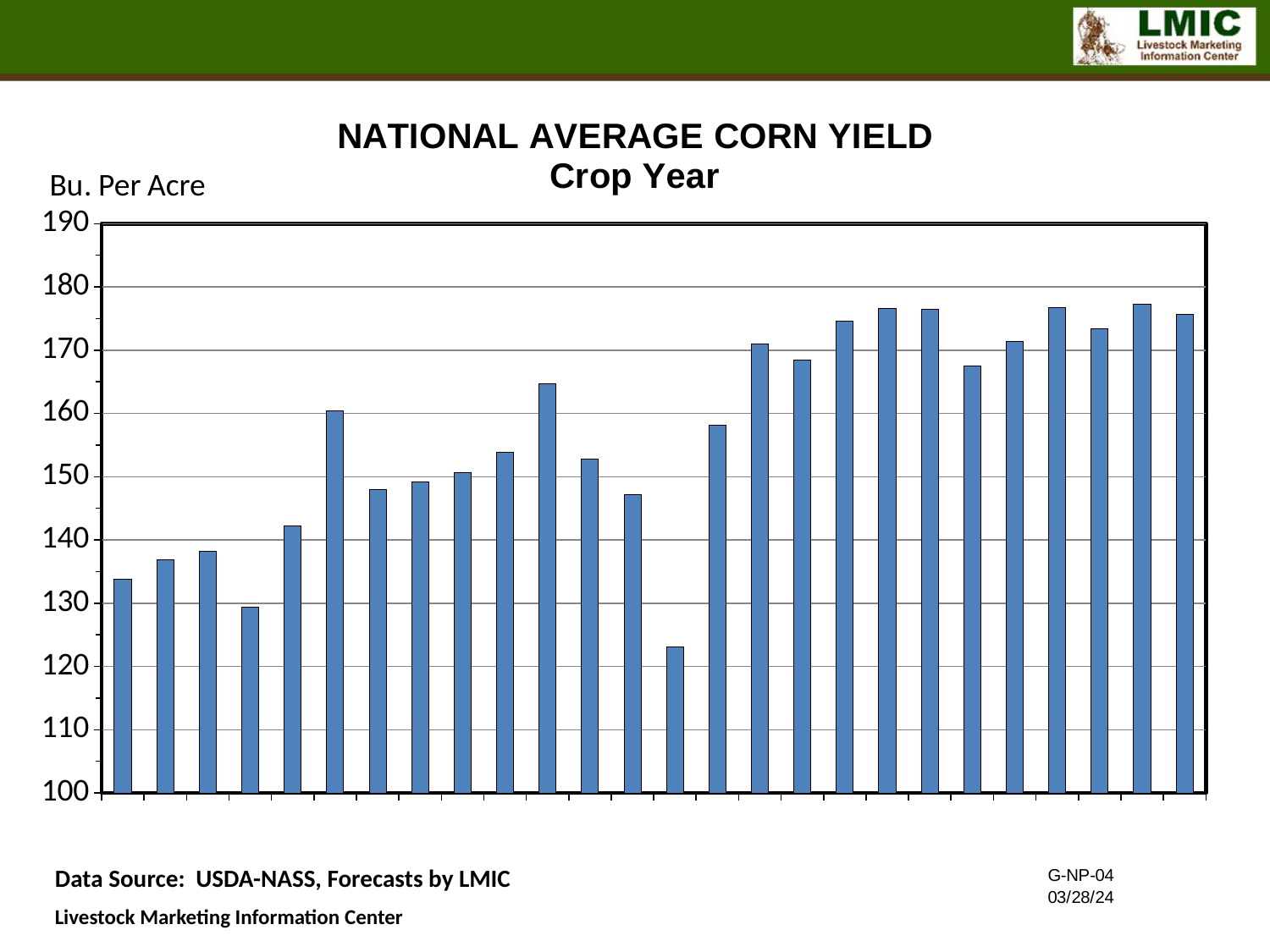
Is the value of the sixth bar from the left greater or less than 150? greater What is the title of the chart? NATIONAL AVERAGE CORN YIELD What is the highest value shown on the vertical axis? 190 What unit label is shown on the vertical axis of the chart? Bu. Per Acre Overall, do the corn yield values rise or fall from left to right across the chart? rise Is the value of the first (leftmost) bar greater or less than 130? greater What kind of chart is shown on the slide? bar chart Which is larger, the fourth bar from the left or the fifth bar from the left? the fifth bar How many bars are plotted in the chart? 26 Is the value of the shortest bar in the chart greater or less than 130? less Which is larger, the first bar or the last bar? the last bar